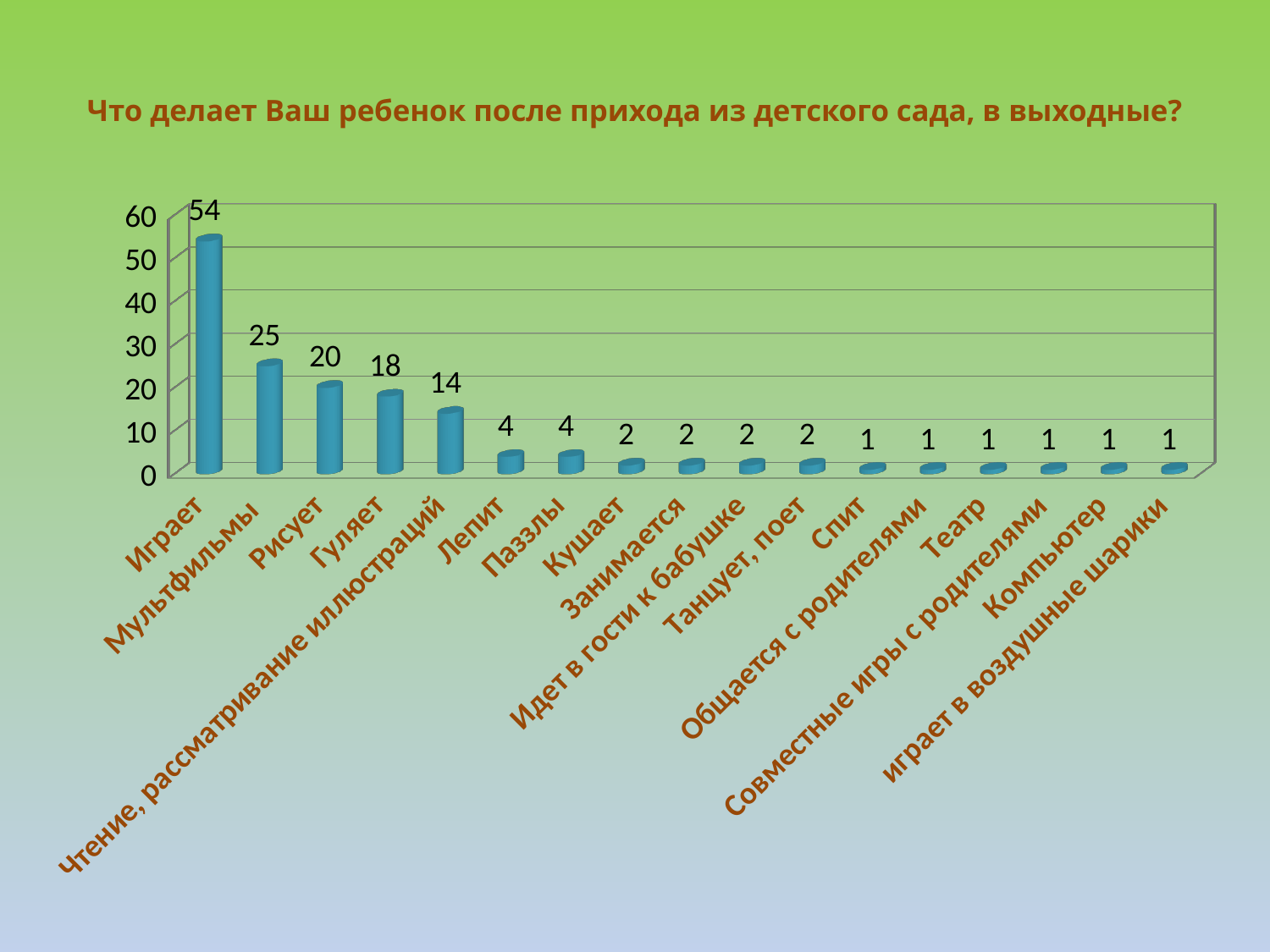
Which category has the highest value? Играет What is the value for Мультфильмы? 25 How many categories are shown on the x axis? 17 What is the difference between the values for Рисует and Гуляет? 2 Is the value for Играет greater or less than 50? greater Which is larger, the value for Гуляет or the value for Чтение, рассматривание иллюстраций? Гуляет What kind of chart is shown on the slide? bar chart What is the difference between the values for Играет and Мультфильмы? 29 What is the value for Играет? 54 What is the value for Чтение, рассматривание иллюстраций? 14 What is the title of the chart? Что делает Ваш ребенок после прихода из детского сада, в выходные? What is the value for Лепит? 4